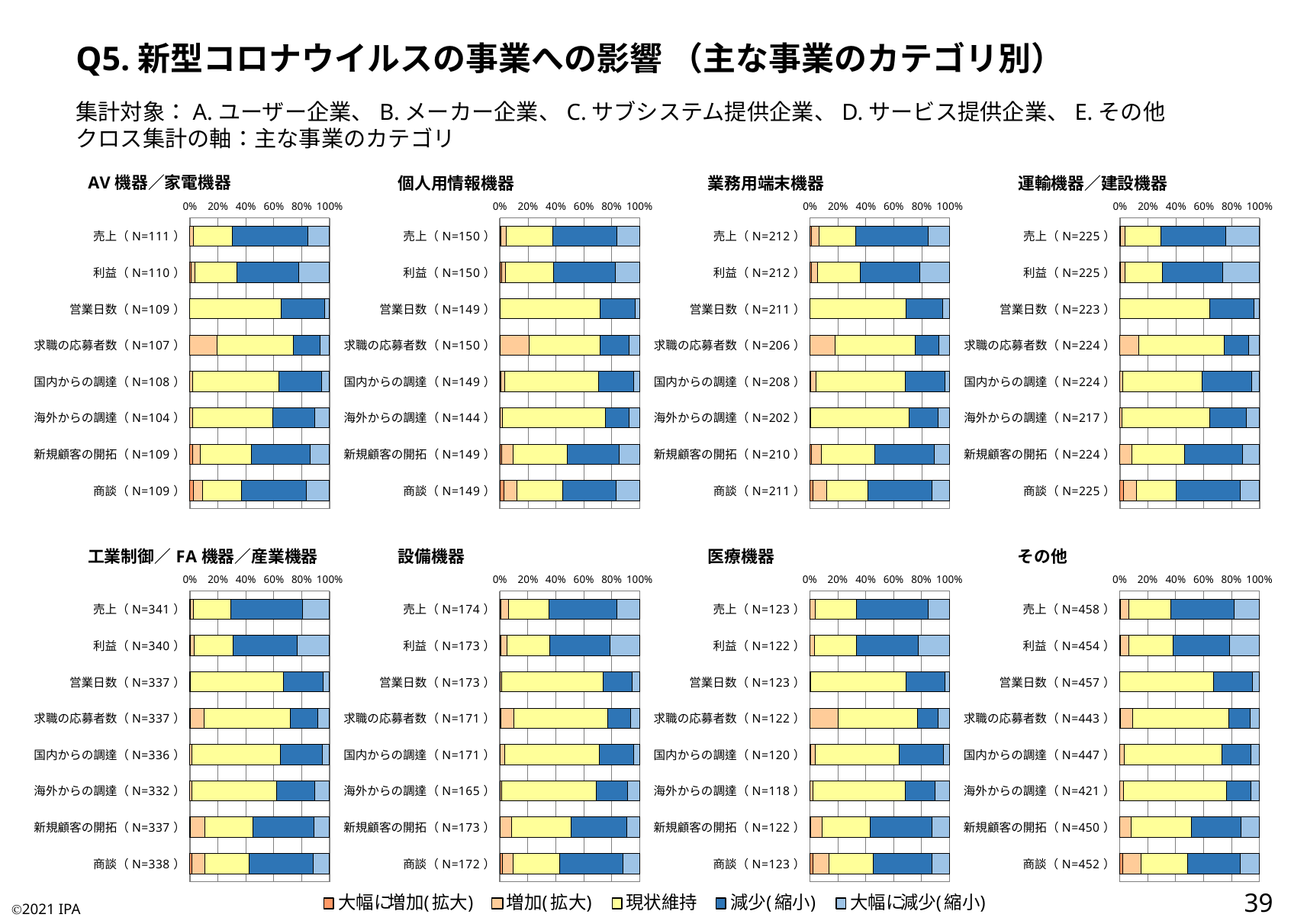
In the その他 chart, is the 現状維持 share for 売上 greater or less than 60%? less What is the title of the top-left chart on the slide? AV機器／家電機器 How many series does the legend at the bottom of the slide list? 5 In the 工業制御／FA機器／産業機器 chart, which has the larger 現状維持 share, 営業日数 or 商談? 営業日数 How many categories are plotted in the 医療機器 chart? 8 In the その他 chart, what is the N shown for 売上? N=458 In the 医療機器 chart, which has the larger 減少(縮小) share, 売上 or 営業日数? 売上 In the 設備機器 chart, is the 現状維持 share for 営業日数 greater or less than 60%? greater In the 業務用端末機器 chart, is the 増加(拡大) share for 求職の応募者数 greater or less than 40%? less How many charts are shown on the slide? 8 What kind of chart is the AV機器／家電機器 chart? stacked bar chart